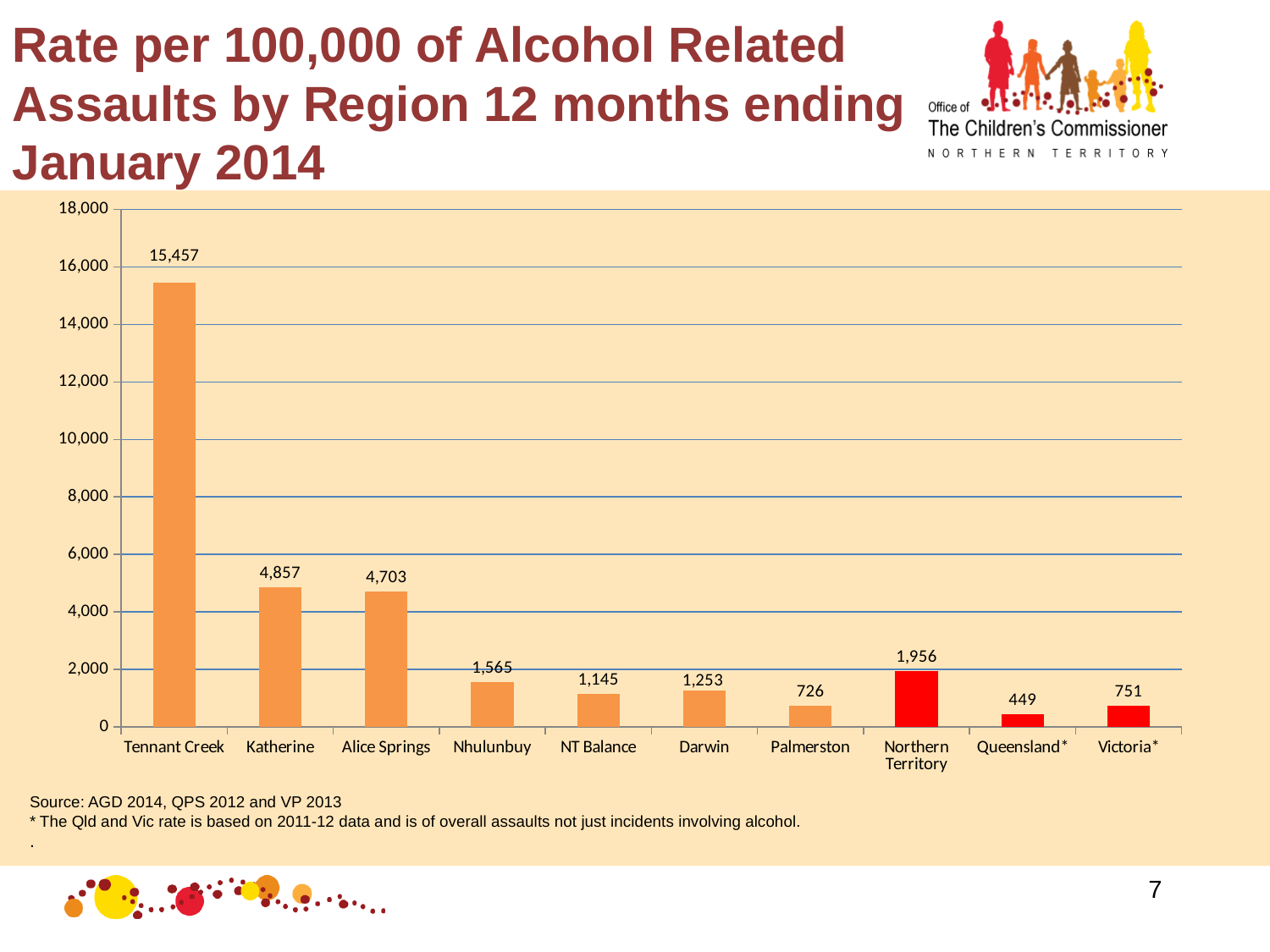
Is the value for Nhulunbuy greater or less than 2,000? less What kind of chart is shown on the slide? bar chart What is the value shown for Northern Territory? 1,956 Which is larger, the value for Darwin or the value for NT Balance? Darwin Which region has the highest rate? Tennant Creek What is the value shown for Queensland*? 449 How many regions are shown on the x axis? 10 What is the difference between the values for Katherine and Alice Springs? 154 What is the rate per 100,000 of alcohol related assaults for Tennant Creek? 15,457 Which region has the lowest rate? Queensland* What is the value shown for Katherine? 4,857 What is the difference between the values for Victoria* and Queensland*? 302